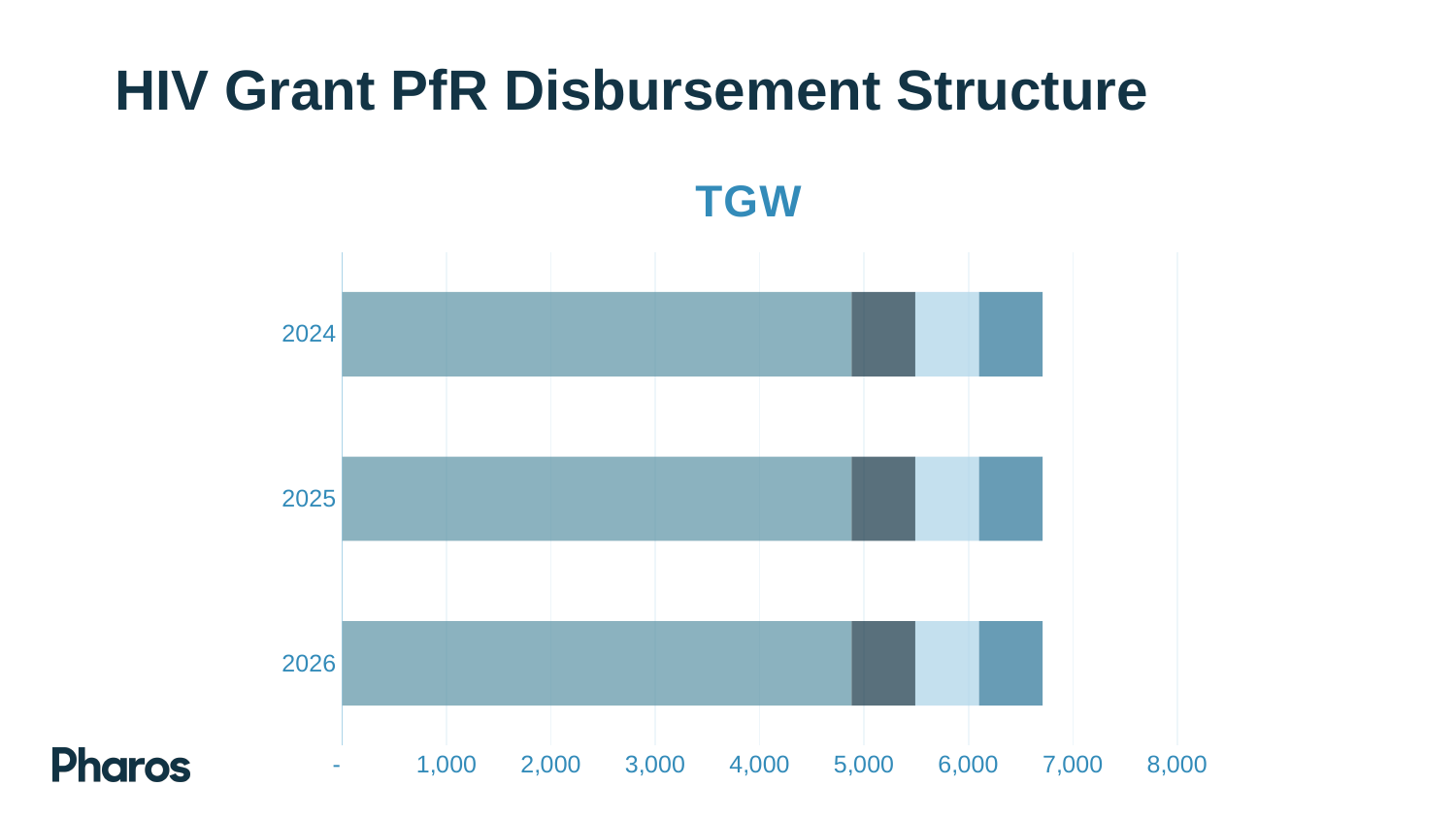
How many categories (years) are shown on the TGW chart? 3 Which year is listed first (at the top) of the TGW chart? 2024 Is the total bar length for 2026 greater or less than 7,000? less Do the total bar lengths rise, fall, or stay the same from 2024 to 2026? stay the same What is the title of the chart on the slide? TGW What kind of chart is the TGW chart? stacked bar chart Is the total bar length for 2024 greater or less than 6,000? greater How many segments make up each stacked bar in the TGW chart? 4 Is the first (leftmost) segment of the 2025 bar greater or less than 4,000? greater What is the highest value shown on the horizontal axis of the TGW chart? 8,000